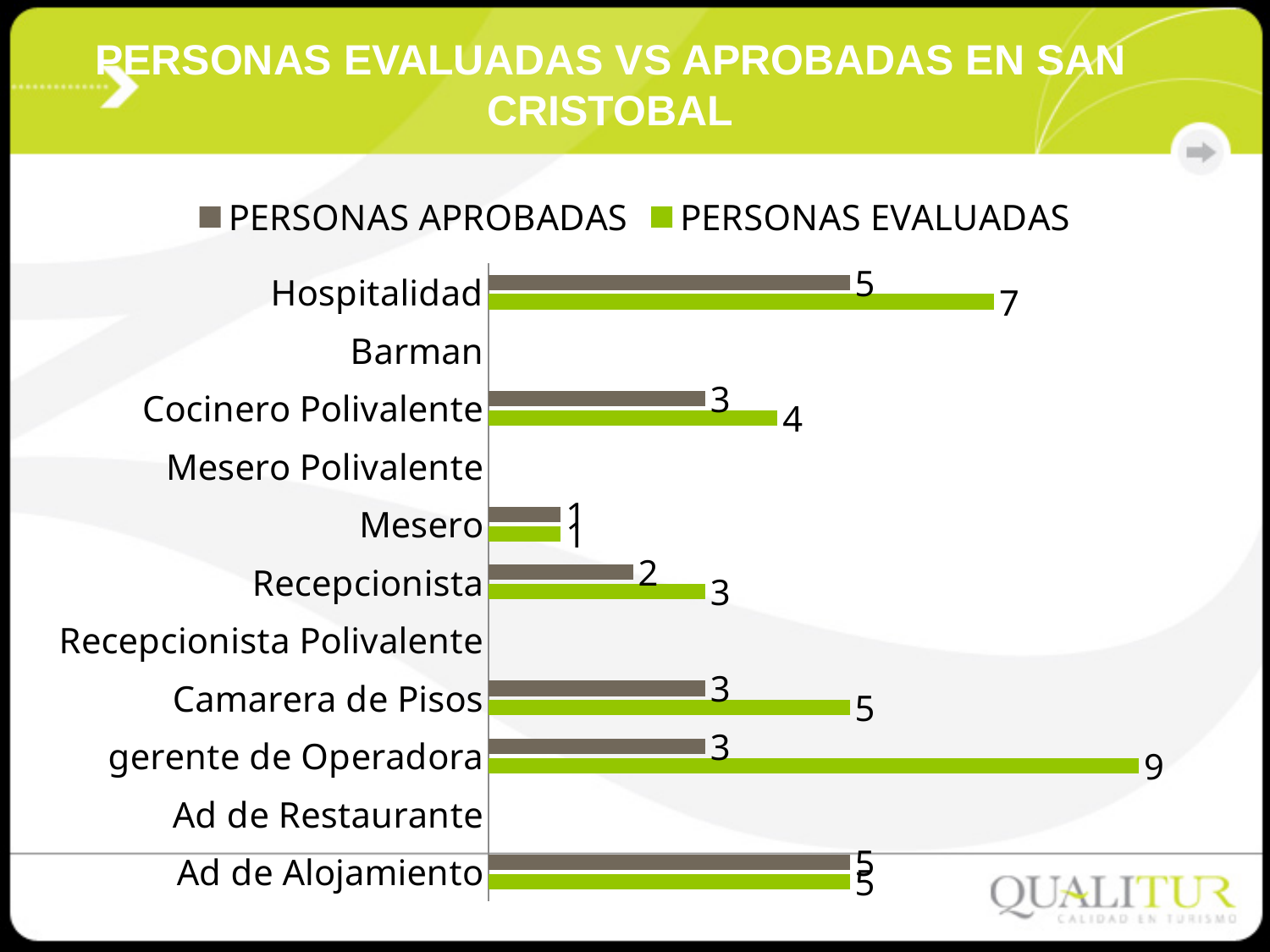
What is the difference between PERSONAS EVALUADAS and PERSONAS APROBADAS for gerente de Operadora? 6 Which is larger for Cocinero Polivalente: PERSONAS EVALUADAS or PERSONAS APROBADAS? PERSONAS EVALUADAS What is the value of PERSONAS EVALUADAS for gerente de Operadora? 9 Which category has the highest value for PERSONAS EVALUADAS? gerente de Operadora How many series does the legend list? 2 What colour are the PERSONAS EVALUADAS bars? green What is the value of PERSONAS EVALUADAS for Hospitalidad? 7 How many categories are listed on the vertical axis of the chart? 11 What is the difference between PERSONAS EVALUADAS and PERSONAS APROBADAS for Camarera de Pisos? 2 What kind of chart is shown on the slide? bar chart What is the value of PERSONAS APROBADAS for Recepcionista? 2 What is the value of PERSONAS APROBADAS for Hospitalidad? 5